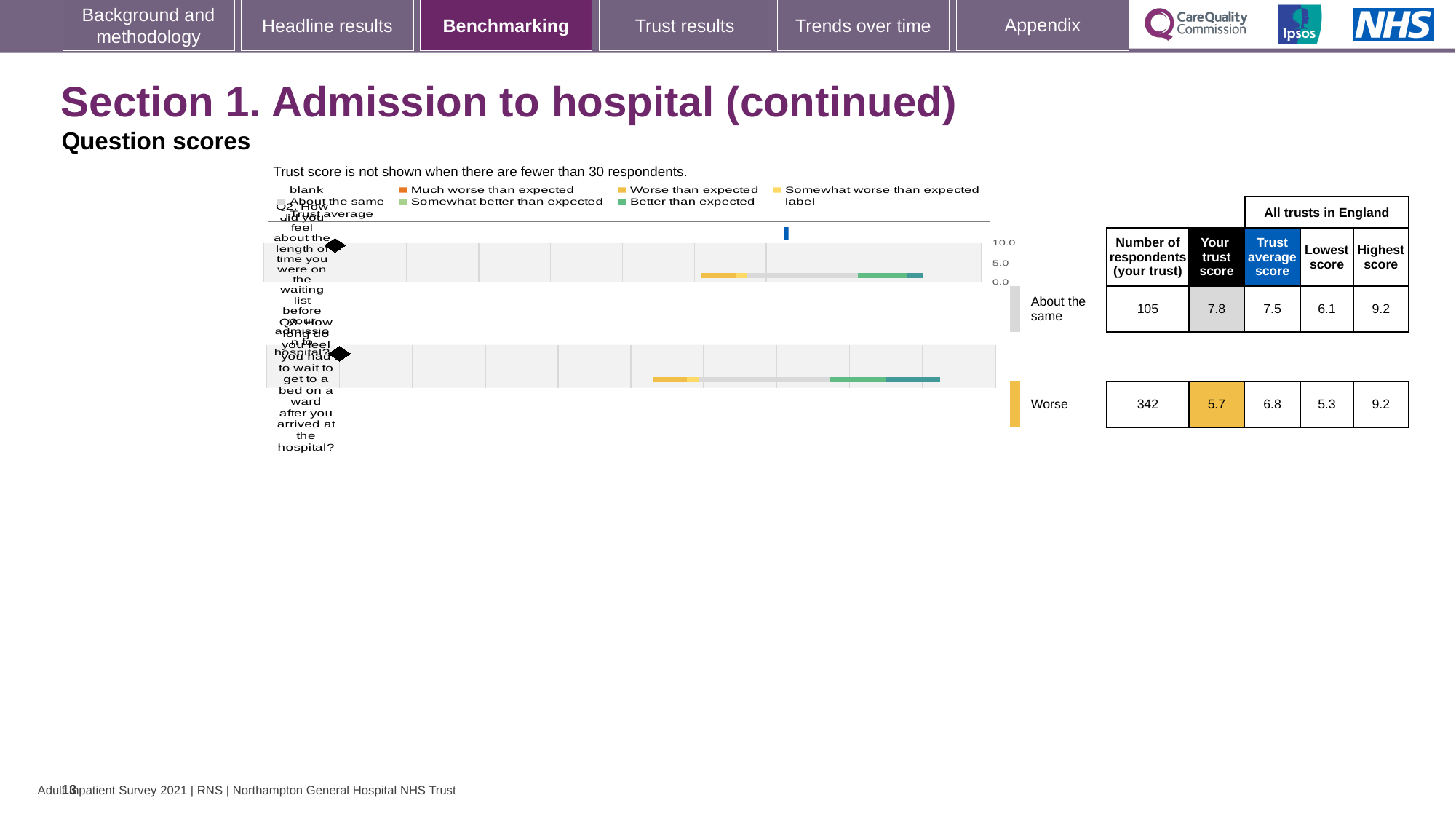
What benchmark category is shown for Q3? Worse What is the highest score across all trusts in England for Q2? 9.2 How many respondents answered Q3 at this trust? 342 What is the trust average score across all trusts in England for Q3? 6.8 How many respondents answered Q2 at this trust? 105 What kind of chart is used to show the question scores on this slide? bar chart By how much does the trust score for Q2 exceed the trust average score for Q2? 0.3 What is the trust score for Q2 (how did you feel about the length of time on the waiting list)? 7.8 Which question has the higher trust score, Q2 or Q3? Q2 By how much is the trust score for Q3 below the trust average score for Q3? 1.1 What is the trust score for Q3 (how long did you feel you had to wait to get to a bed on a ward)? 5.7 How many questions are plotted in the question scores chart? 2